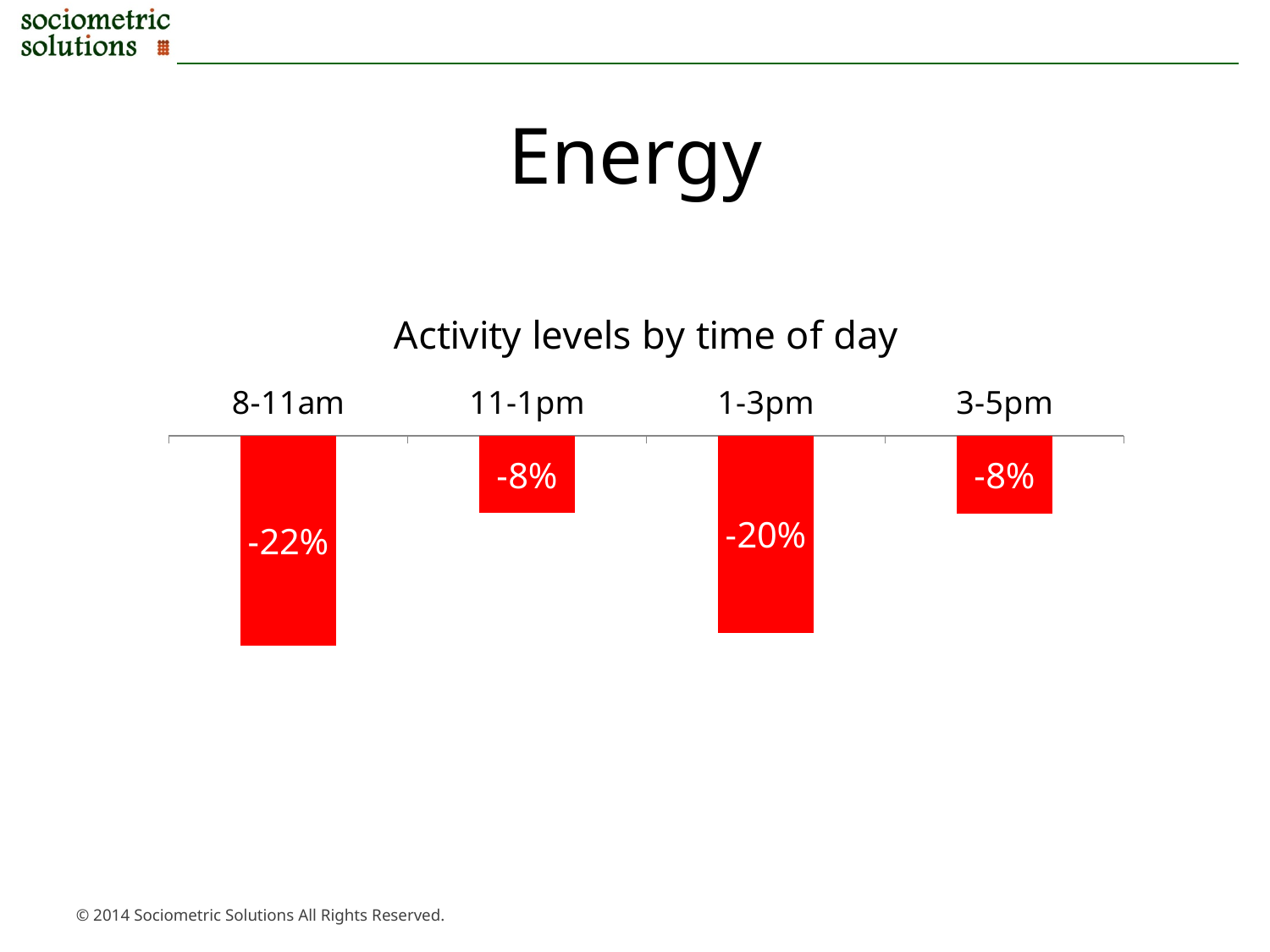
What is the title of the chart? Activity levels by time of day How many time-of-day categories are shown in the chart? 4 What is the difference between the values for 8-11am and 1-3pm? 2% Which time of day has the lowest value? 8-11am What is the value for 11-1pm? -8% Which is larger, the value for 11-1pm or the value for 1-3pm? 11-1pm What kind of chart is shown on the slide? Bar chart What is the difference between the values for 1-3pm and 3-5pm? 12% What colour are the bars in the chart? Red What is the value for 3-5pm? -8% What is the value for 8-11am? -22% What is the value for 1-3pm? -20%